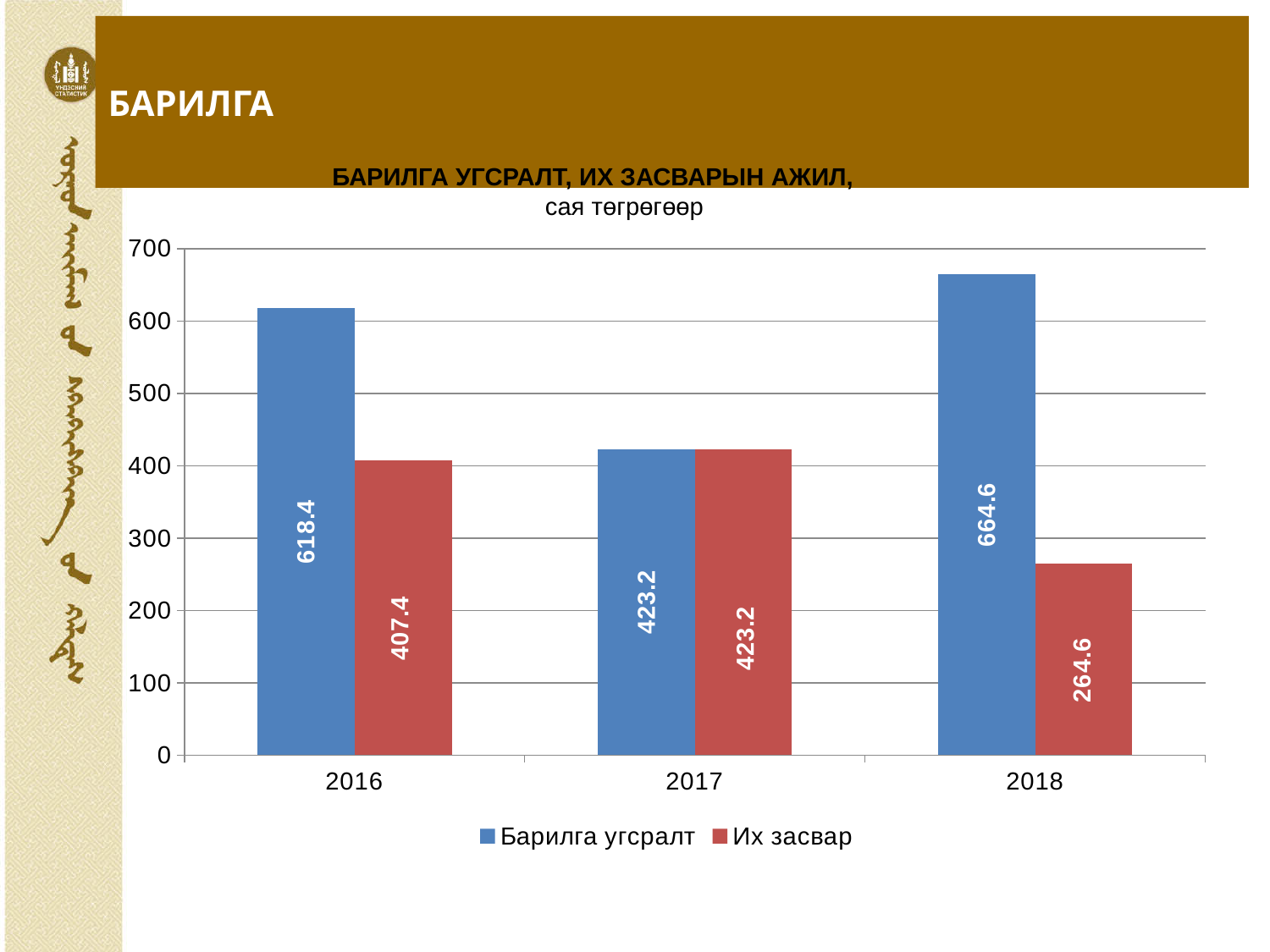
What is the value for Барилга угсралт in 2016? 618.4 How many years are shown on the x axis? 3 How many series does the legend list? 2 What is the value for Их засвар in 2017? 423.2 In which year is Барилга угсралт highest? 2018 What is the difference between Барилга угсралт and Их засвар in 2018? 400.0 What is the value for Их засвар in 2018? 264.6 In which year is Их засвар lowest? 2018 Is the value for Барилга угсралт in 2018 greater or less than 600? greater What kind of chart is shown on the slide? bar chart What is the difference between Барилга угсралт in 2018 and in 2016? 46.2 Which is larger in 2016, Барилга угсралт or Их засвар? Барилга угсралт